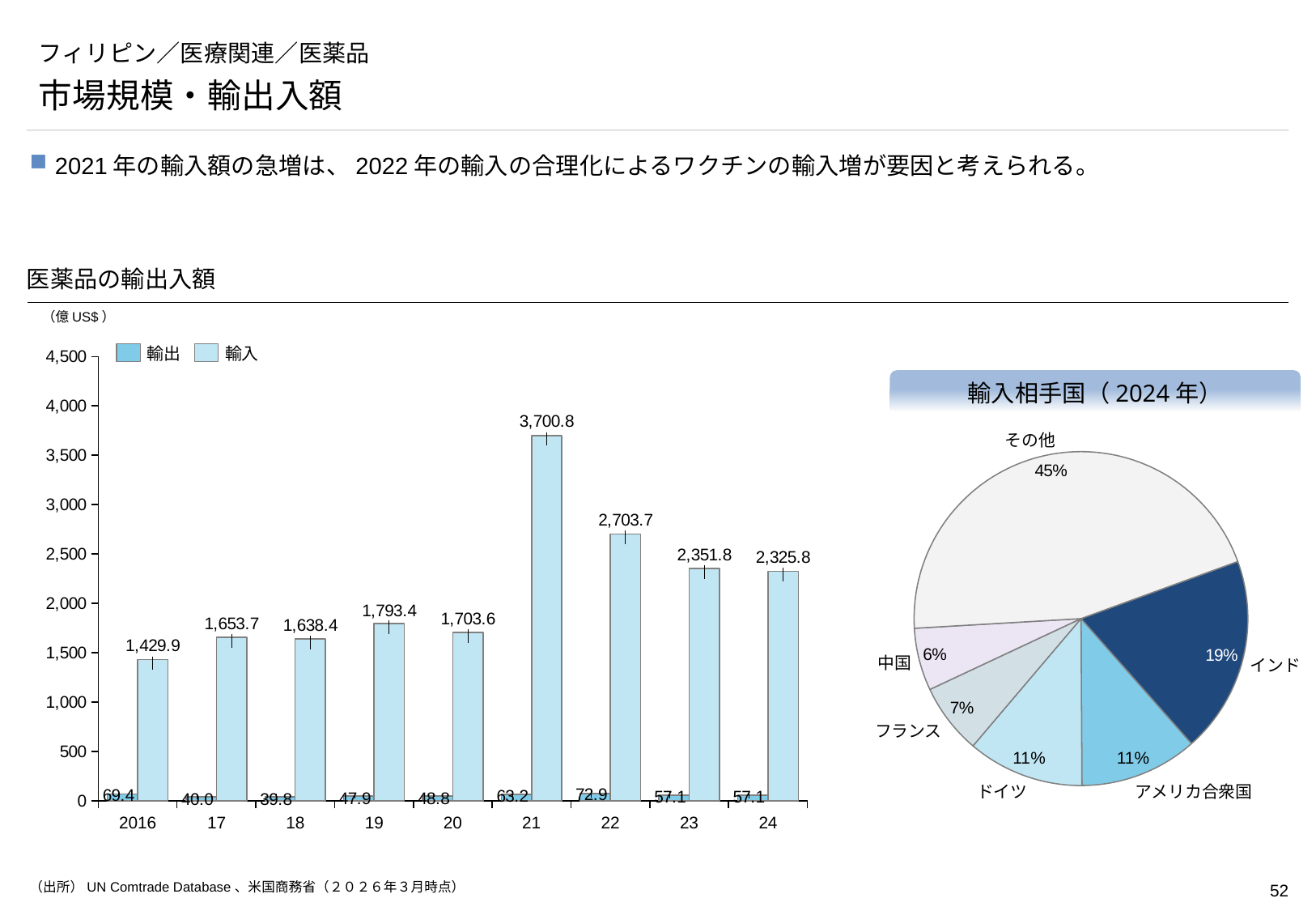
In the bar chart 医薬品の輸出入額, what is the 輸出 value for 2016? 69.4 In the bar chart 医薬品の輸出入額, what is the difference between the 輸入 values for 2021 and 2022? 997.1 In the pie chart 輸入相手国（2024年）, how many slices are there? 6 In the bar chart 医薬品の輸出入額, how many years are shown on the x axis? 9 In the bar chart 医薬品の輸出入額, which is larger, the 輸出 value for 2022 or for 2023? 2022 In the pie chart 輸入相手国（2024年）, what share does インド have? 19% What kind of chart is 医薬品の輸出入額? bar chart In the bar chart 医薬品の輸出入額, what is the 輸入 value for 2021? 3,700.8 In the bar chart 医薬品の輸出入額, which year has the lowest 輸入 value? 2016 In the bar chart 医薬品の輸出入額, which year has the highest 輸入 value? 21 In the bar chart 医薬品の輸出入額, how many series does the legend list? 2 In the pie chart 輸入相手国（2024年）, which category has the smallest share? 中国